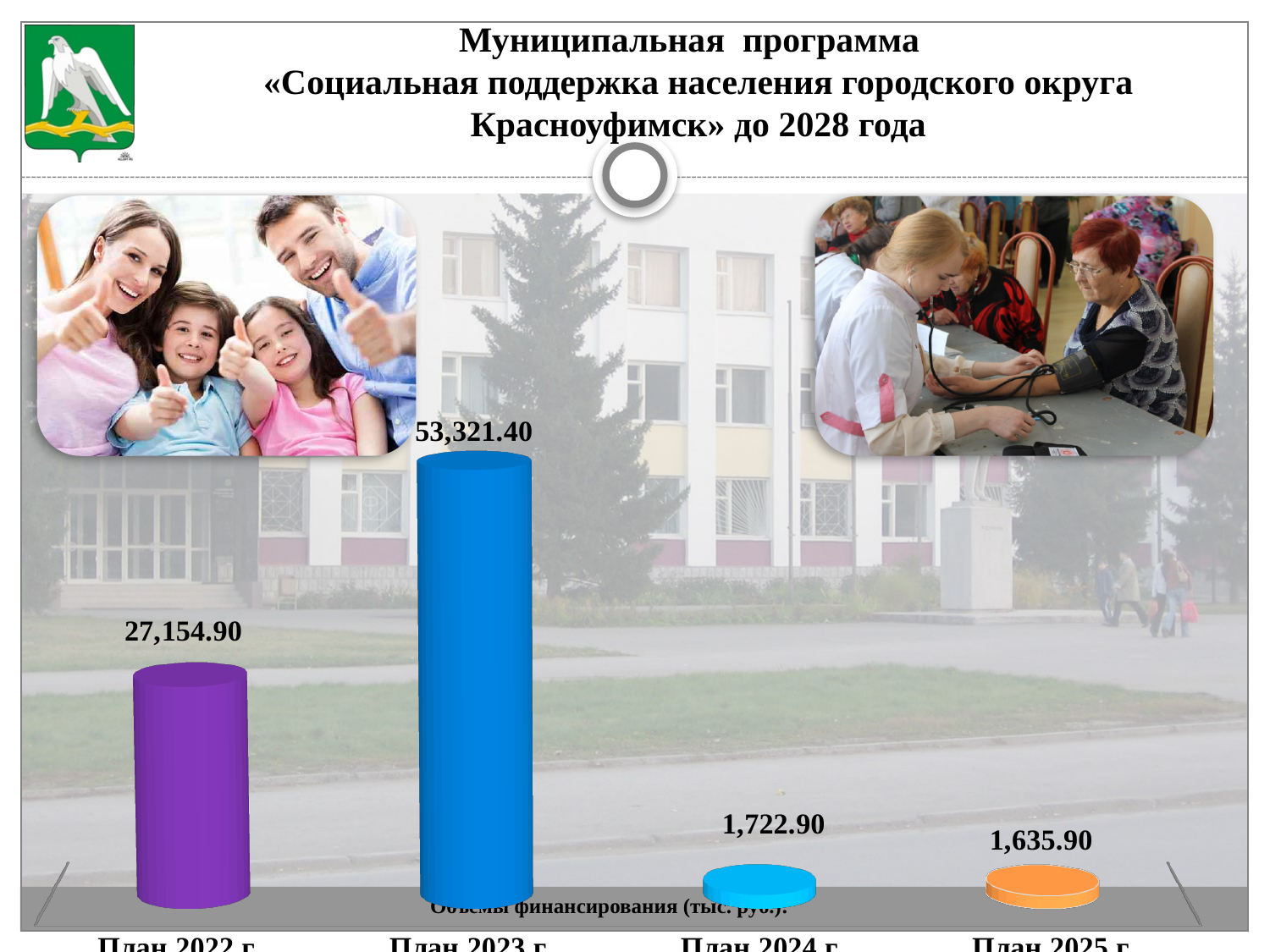
What kind of chart is shown on the slide? Bar chart Do the values rise or fall from План 2023 г. to План 2025 г.? Fall What is the difference between the values for План 2023 г. and План 2022 г.? 26,166.50 Which category has the lowest value? План 2025 г. What is the value for План 2025 г.? 1,635.90 Which category has the highest value? План 2023 г. How many categories are shown in the chart? 4 What is the value for План 2024 г.? 1,722.90 Which is larger, the value for План 2024 г. or План 2025 г.? План 2024 г. What is the difference between the values for План 2024 г. and План 2025 г.? 87.00 What is the value for План 2023 г.? 53,321.40 What is the value for План 2022 г.? 27,154.90